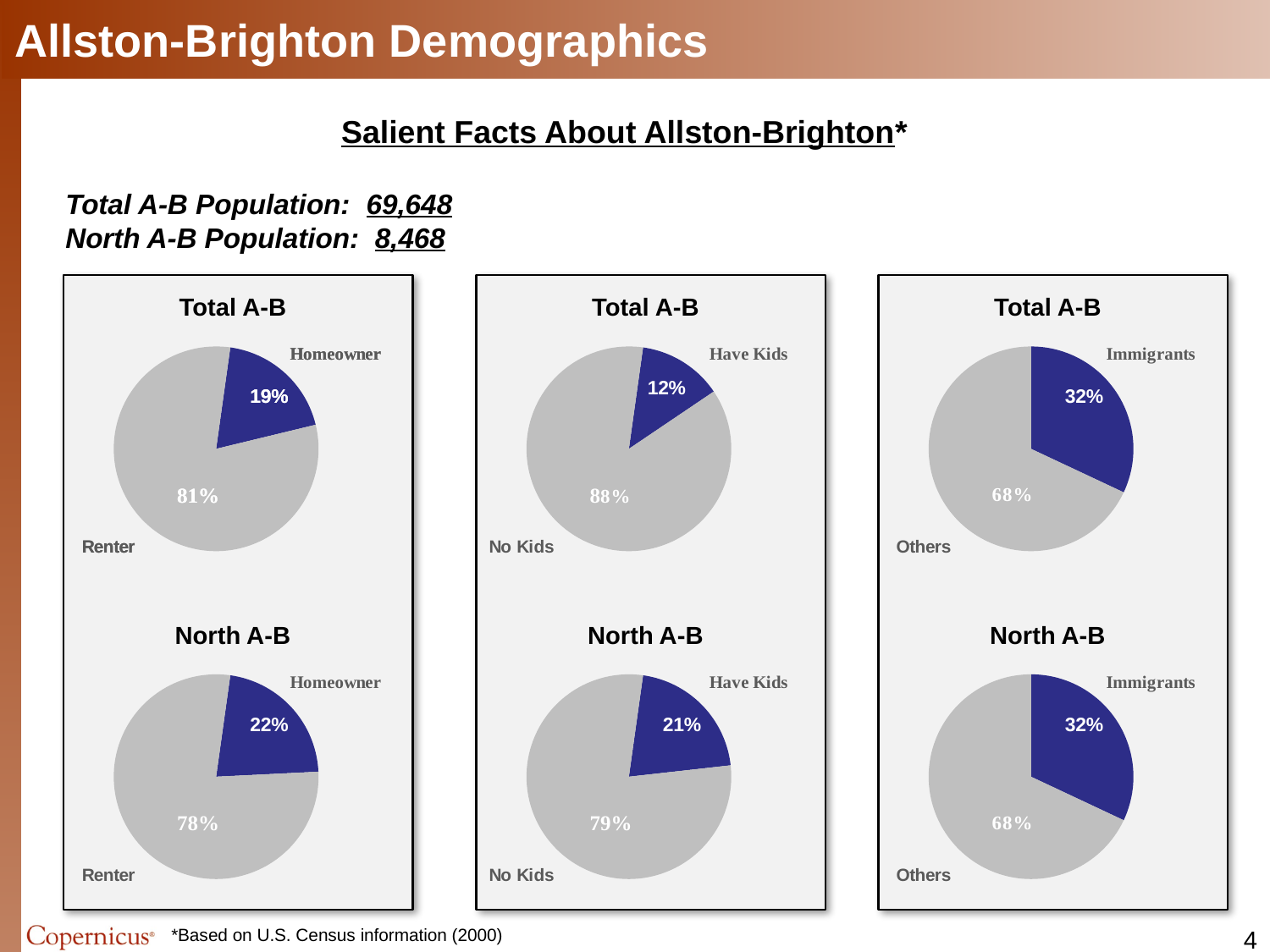
In the top-left pie chart (Total A-B, Homeowner vs Renter), what percentage are homeowners? 19% In the top-left pie chart (Total A-B, Homeowner vs Renter), which slice is the largest? Renter In the bottom-left pie chart (North A-B, Homeowner vs Renter), what percentage are renters? 78% What type of chart is used for the Total A-B Immigrants vs Others chart (top-right)? Pie chart In the top-right pie chart (Total A-B, Immigrants vs Others), what percentage are immigrants? 32% In the top-middle pie chart (Total A-B, Have Kids vs No Kids), what percentage have kids? 12% How many pie charts are shown on the slide? 6 In the bottom-right pie chart (North A-B, Immigrants vs Others), what percentage are Others? 68% Which is larger: the Homeowner share in the Total A-B pie chart (top-left) or the Homeowner share in the North A-B pie chart (bottom-left)? North A-B In the bottom-middle pie chart (North A-B, Have Kids vs No Kids), what percentage have no kids? 79% In the bottom-middle pie chart (North A-B, Have Kids vs No Kids), which slice is the smallest? Have Kids What is the difference between the Have Kids share in the North A-B pie chart (bottom-middle) and the Have Kids share in the Total A-B pie chart (top-middle)? 9%